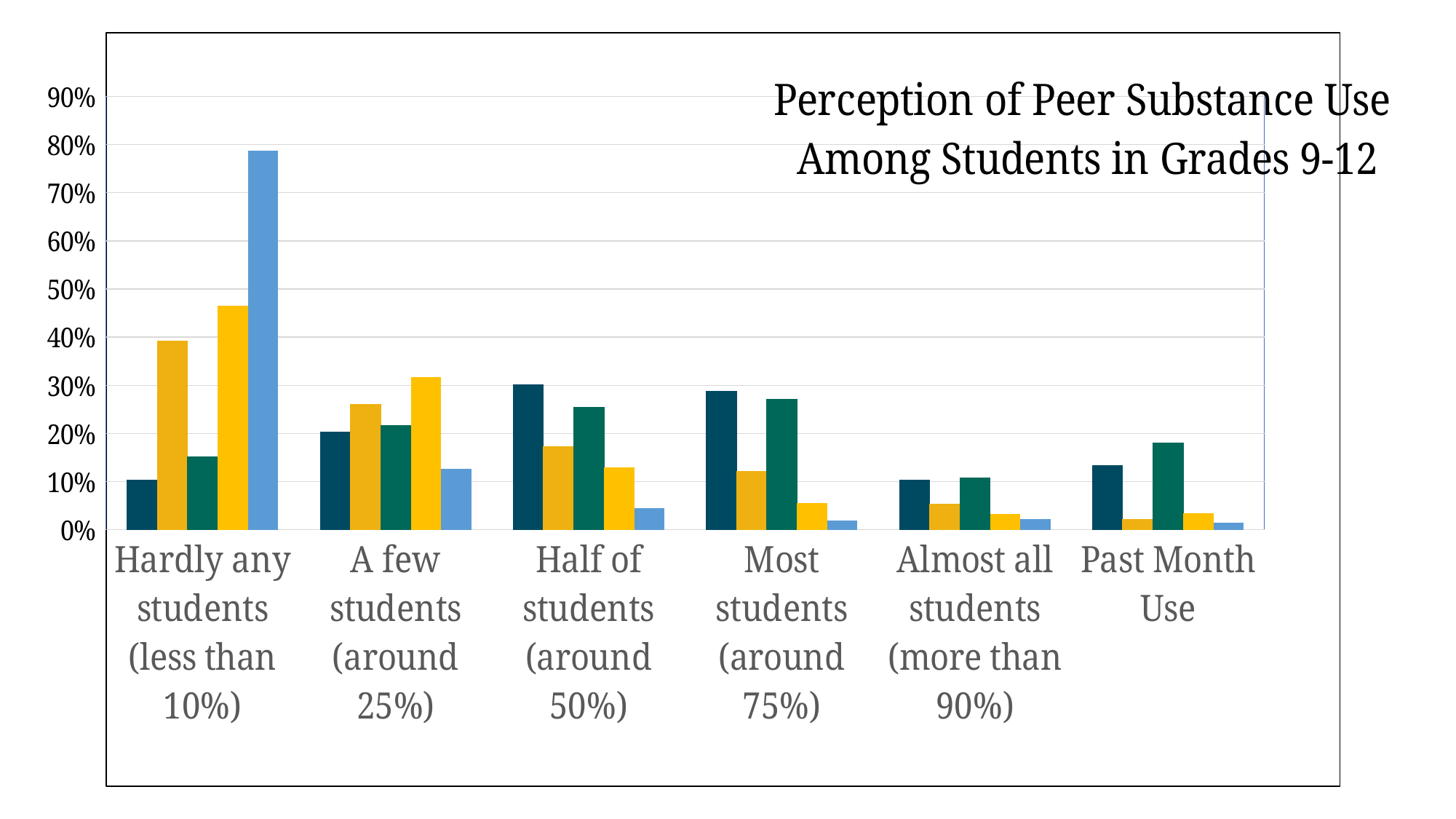
What is the title of the chart? Perception of Peer Substance Use Among Students in Grades 9-12 In the "A few students (around 25%)" category, which is taller: the yellow bar or the dark teal bar? The yellow bar Is the value of the light blue bar for "Past Month Use" greater or less than 10%? less Is the value of the dark teal bar for "Half of students (around 50%)" greater or less than 20%? greater Which category contains the tallest bar in the chart? Hardly any students (less than 10%) How many bars are plotted for each category? 5 Is the value of the green bar for "Past Month Use" greater or less than 10%? greater In the "Hardly any students (less than 10%)" category, which is taller: the yellow bar or the orange bar? The yellow bar What kind of chart is shown on the slide? Bar chart How many categories are shown along the x axis? 6 Do the light blue bars rise or fall from "Hardly any students" to "Almost all students" along the x axis? Fall